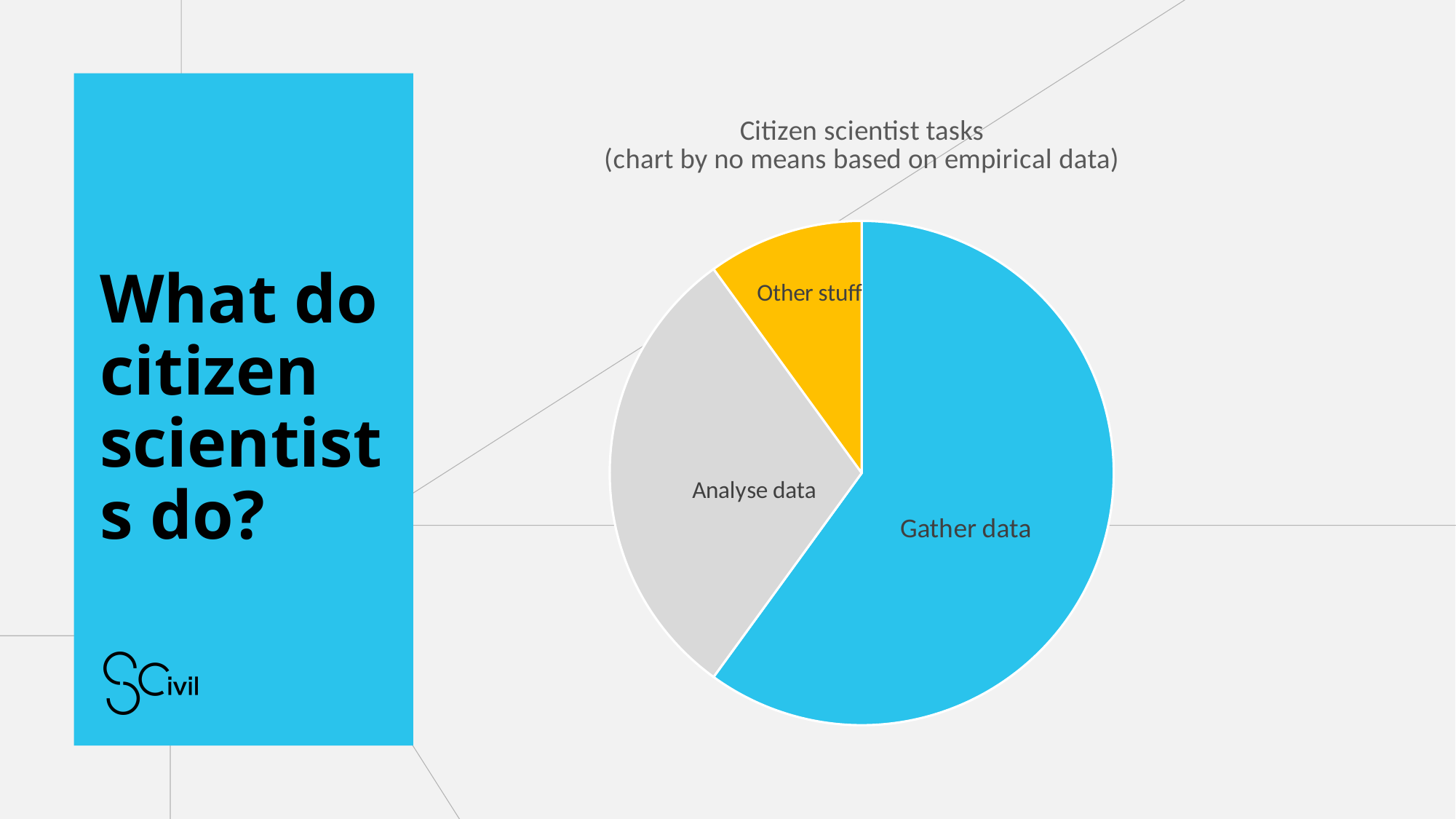
Which task has the smallest slice of the pie chart? Other stuff Does the Gather data slice take up more or less than half of the pie? more Which slice is larger, Gather data or Analyse data? Gather data What colour is the Gather data slice? blue What kind of chart is shown on the slide? pie chart Which slice is larger, Analyse data or Other stuff? Analyse data How many slices does the pie chart have? 3 Which task has the largest slice of the pie chart? Gather data What is the title of the pie chart? Citizen scientist tasks (chart by no means based on empirical data)